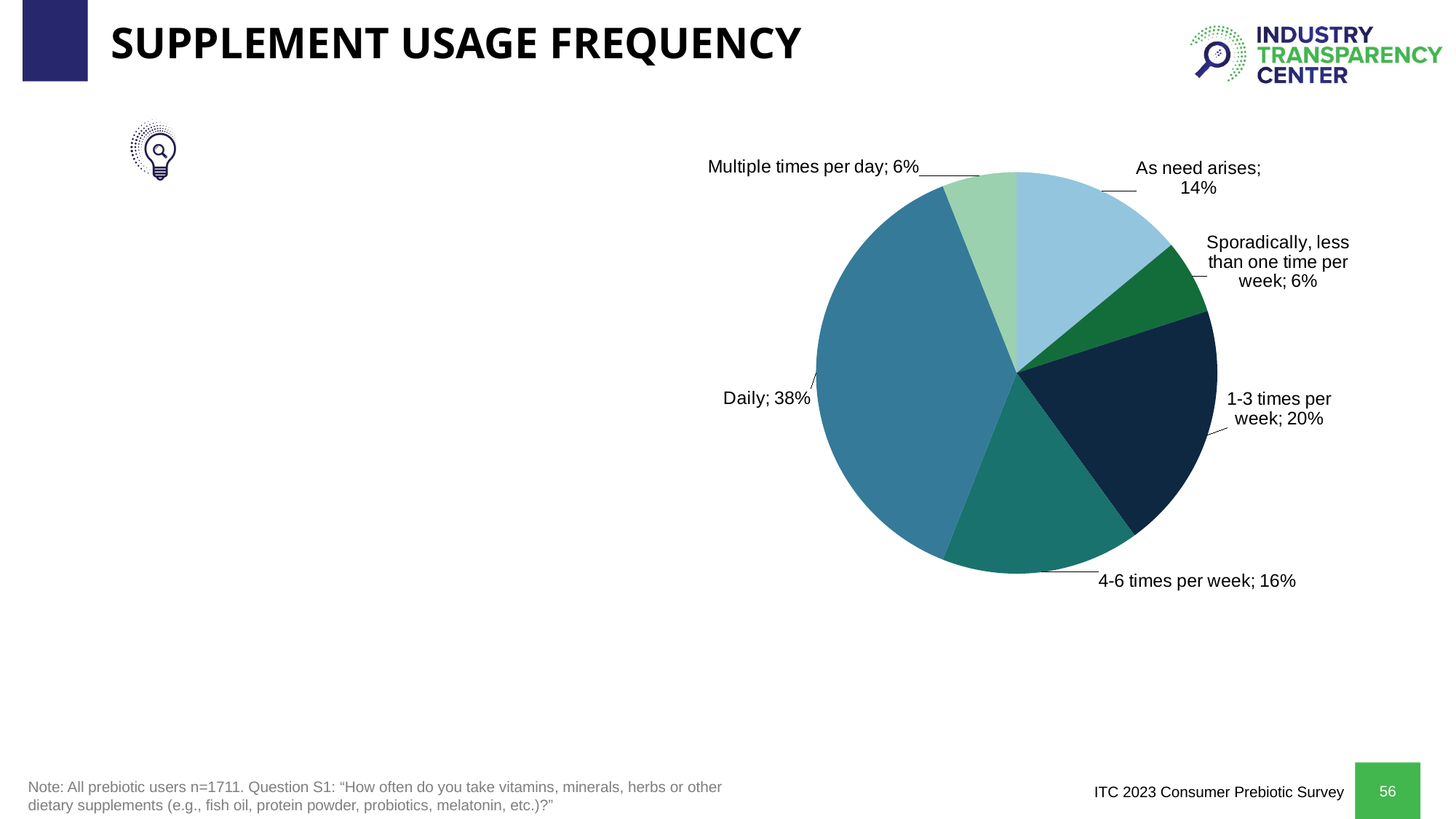
How many slices does the pie chart have? 6 What is the difference in percentage points between Daily and 1-3 times per week? 18 Which is larger, the slice for 4-6 times per week or the slice for As need arises? 4-6 times per week What share of the pie is labelled Daily? 38% What percentage is shown for 1-3 times per week? 20% Which category has the largest slice of the pie? Daily What is the title of the slide containing the chart? SUPPLEMENT USAGE FREQUENCY What percentage is shown for As need arises? 14% What is the combined percentage of Multiple times per day and Sporadically, less than one time per week? 12% What percentage is shown for Multiple times per day? 6% What kind of chart is shown on the slide? Pie chart What percentage is shown for 4-6 times per week? 16%